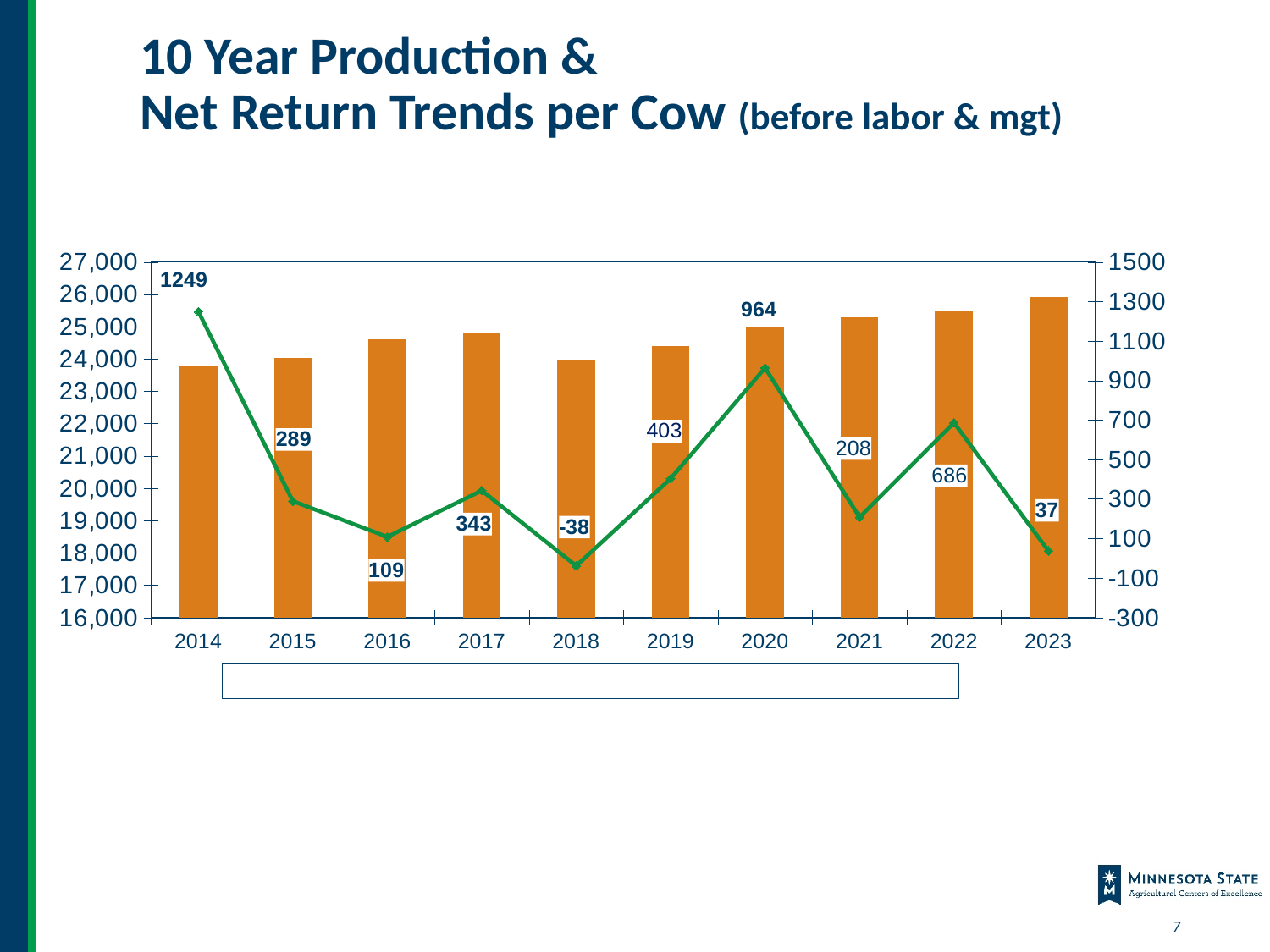
How many years are shown on the x axis? 10 Is the orange bar for 2016 greater or less than 24,000 on the left axis? greater What is the data label on the green line for 2020? 964 What is the green line's value for 2023? 37 What is the difference between the green line's values for 2020 and 2021? 756 Do the orange bars rise or fall from 2019 to 2023? rise In which year does the green line reach its highest value? 2014 What value does the green line show for 2018? -38 Which year has the larger green line value, 2019 or 2022? 2022 In which year does the green line reach its lowest value? 2018 What kind of chart is shown on the slide? A combined bar chart and line chart Is the orange bar for 2023 greater or less than 25,000 on the left axis? greater